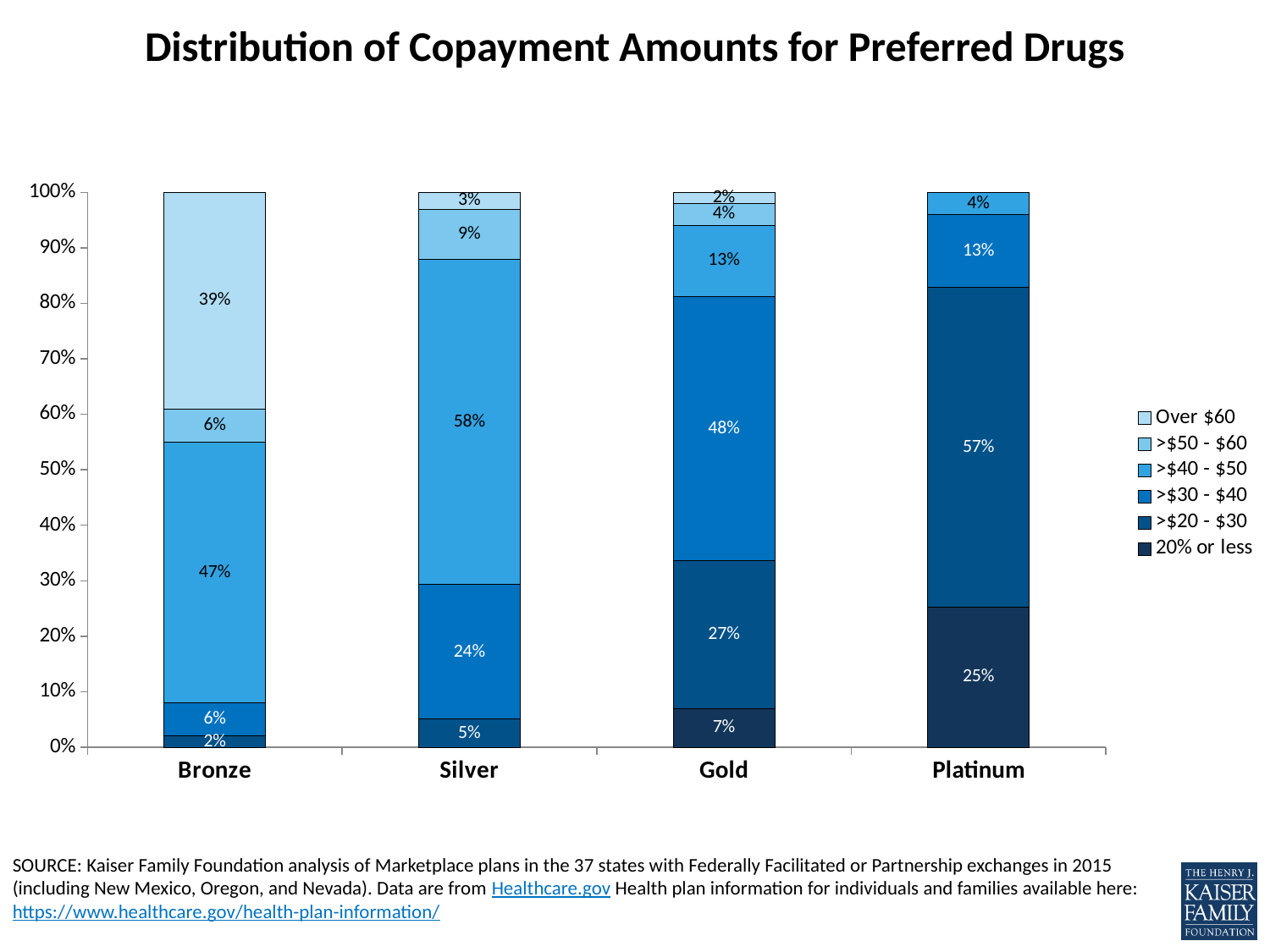
What share of Bronze plans have copayments Over $60? 39% How many series does the legend list? 6 What is the value of the bottom (20% or less) segment for Gold? 7% How many plan categories are shown on the x axis? 4 What is the first entry listed in the legend? Over $60 What is the value of the bottom (20% or less) segment for Platinum? 25% What kind of chart is shown on the slide? Stacked bar chart Which plan category has the largest Over $60 share? Bronze Which is larger: the largest segment in the Silver bar or the largest segment in the Gold bar? Silver (58%) What is the value of the largest segment in the Platinum bar? 57% What is the difference between the Over $60 share for Bronze and for Silver? 36 percentage points What is the value of the largest segment in the Silver bar? 58%